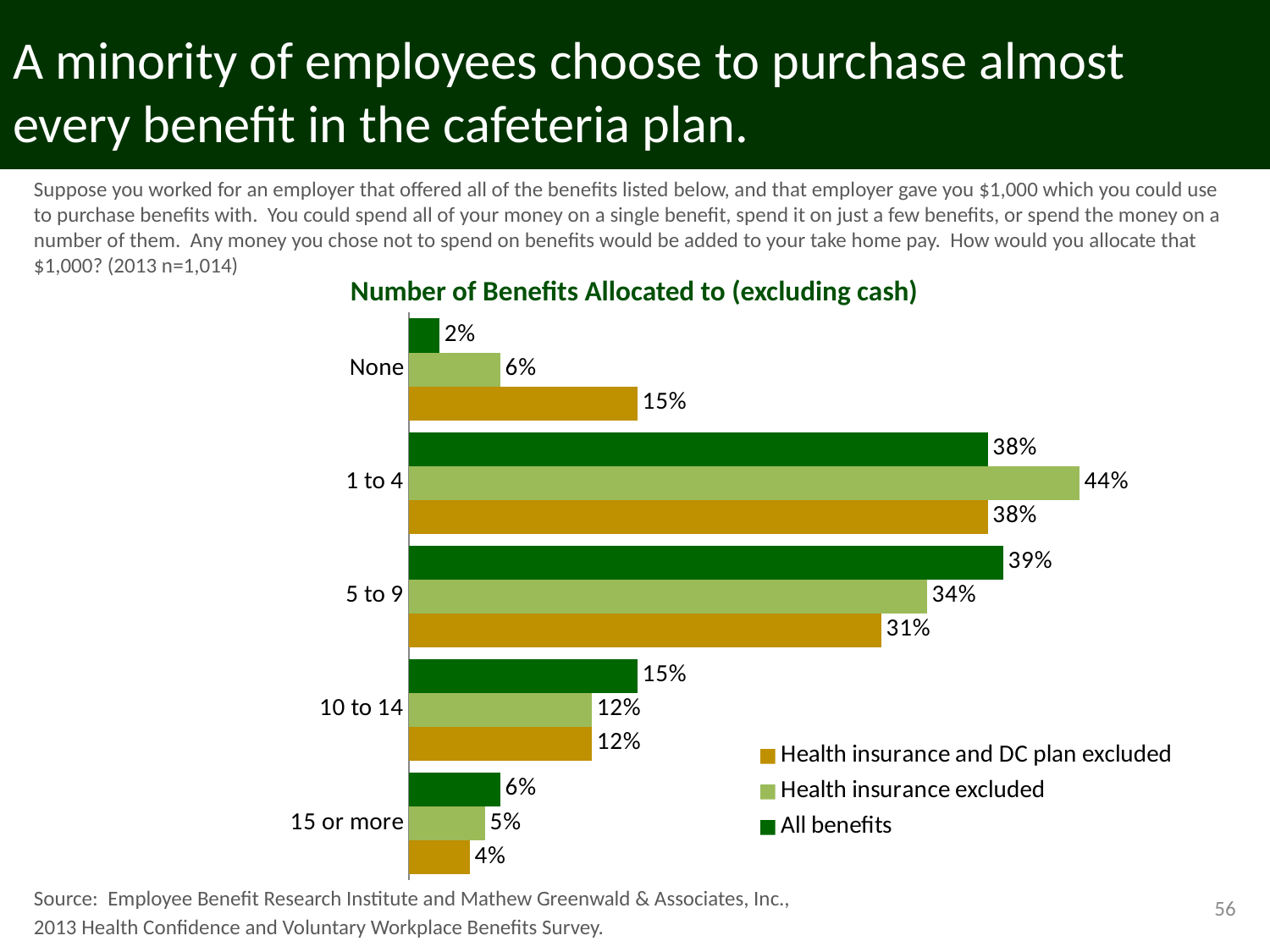
For 5 to 9 benefits, which is larger: the All benefits value or the Health insurance and DC plan excluded value? All benefits What percentage of respondents allocated to 1 to 4 benefits in the Health insurance excluded series? 44% What is the difference between the Health insurance excluded and All benefits values for 1 to 4 benefits? 6% What is the title of the chart? Number of Benefits Allocated to (excluding cash) What is the value for 15 or more benefits in the Health insurance and DC plan excluded series? 4% What kind of chart is shown on the slide? Bar chart Which category has the highest value in the All benefits series? 5 to 9 How many categories are shown on the chart? 5 How many series does the legend list? 3 Which category has the lowest value in the Health insurance excluded series? 15 or more What is the value for None in the Health insurance and DC plan excluded series? 15% What is the value for 5 to 9 benefits in the All benefits series? 39%